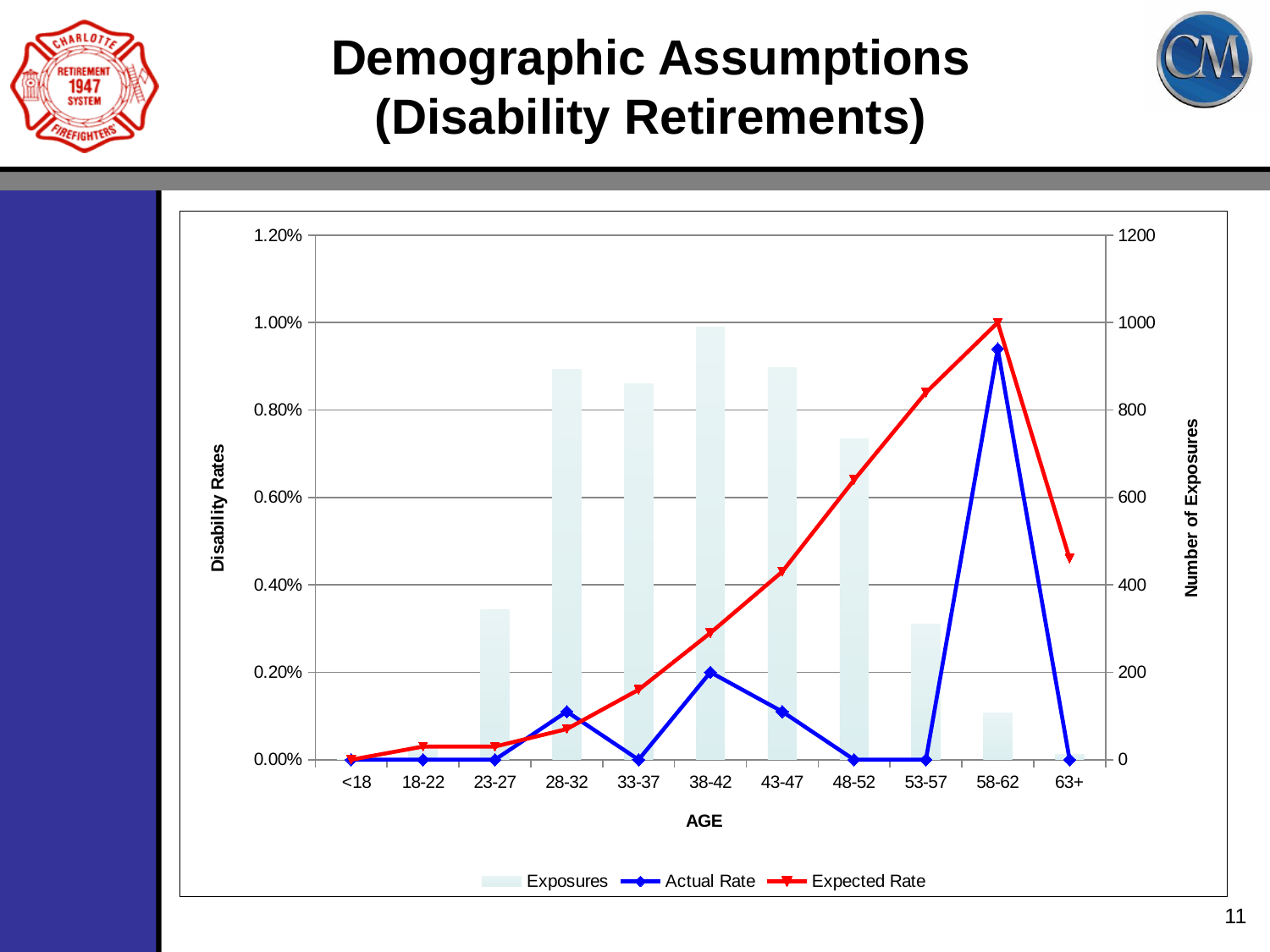
Which age group has the highest number of Exposures? 38-42 Which age group has the highest Expected Rate? 58-62 How many age categories are shown on the x axis? 11 Which age group has the highest Actual Rate? 58-62 What is the title of the right-hand vertical axis? Number of Exposures Is the Expected Rate for the 63+ age group greater or less than 0.40%? greater For the 48-52 age group, which is larger: the Actual Rate or the Expected Rate? Expected Rate What kind of chart is shown on the slide? A combination bar and line chart How many series does the legend list? 3 Is the number of Exposures for the 58-62 age group greater or less than 200? less What is the Actual Rate for the 48-52 age group? 0.00% Does the Expected Rate rise or fall from the <18 age group to the 58-62 age group? Rises